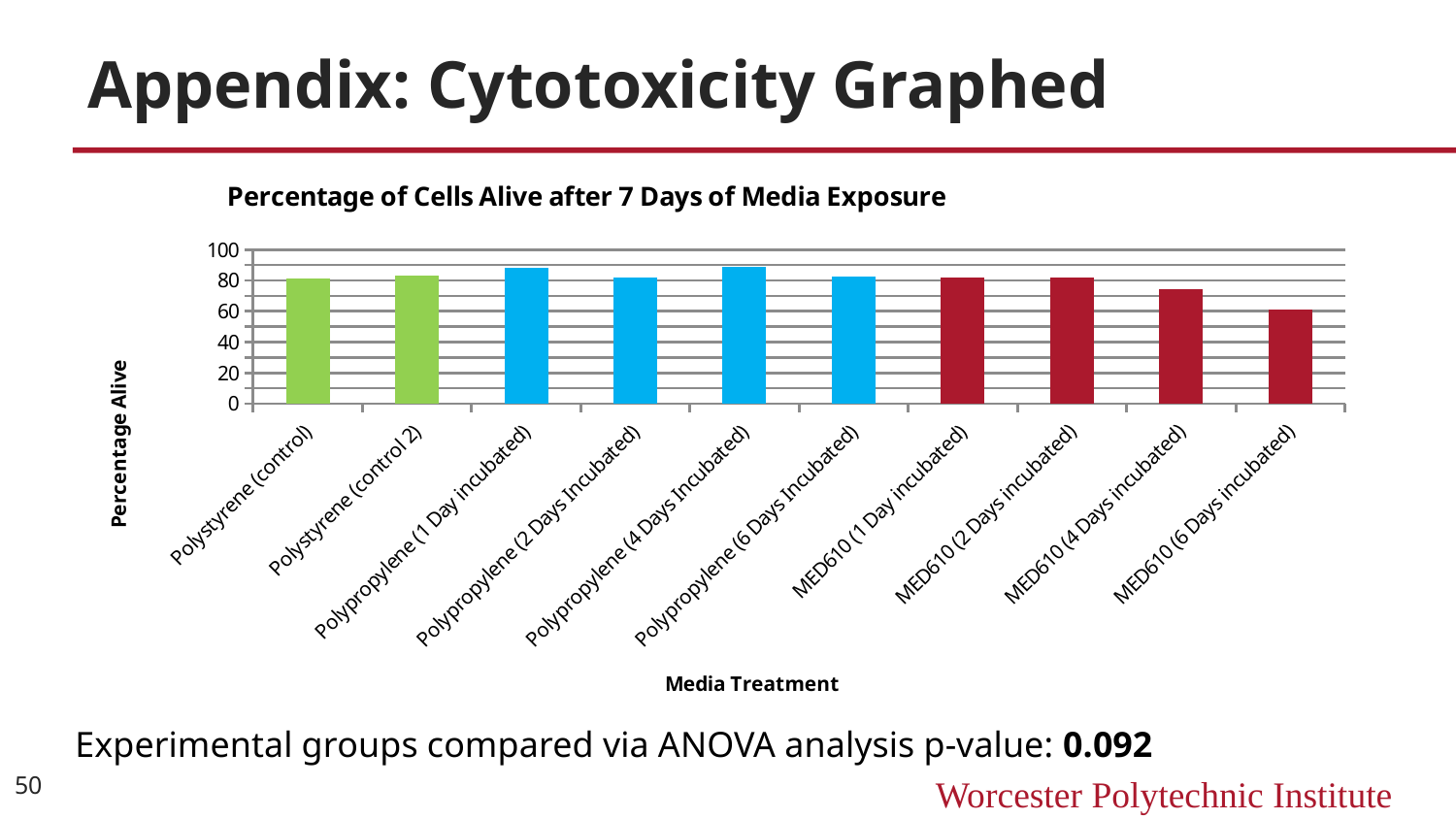
Do the MED610 bars rise or fall from 1 Day incubated to 6 Days incubated? fall Which media treatment has the lowest percentage of cells alive? MED610 (6 Days incubated) Is the value for Polystyrene (control) greater or less than 60? greater How many media treatment categories are plotted in the chart? 10 What kind of chart is shown on the slide? bar chart What is the label on the vertical axis of the chart? Percentage Alive Which has a higher percentage alive: Polypropylene (4 Days Incubated) or MED610 (4 Days incubated)? Polypropylene (4 Days Incubated) Is the value for MED610 (4 Days incubated) greater or less than 80? less Which has a higher percentage alive: MED610 (4 Days incubated) or MED610 (6 Days incubated)? MED610 (4 Days incubated) Is the value for Polypropylene (1 Day incubated) greater or less than 80? greater What is the title of the chart? Percentage of Cells Alive after 7 Days of Media Exposure